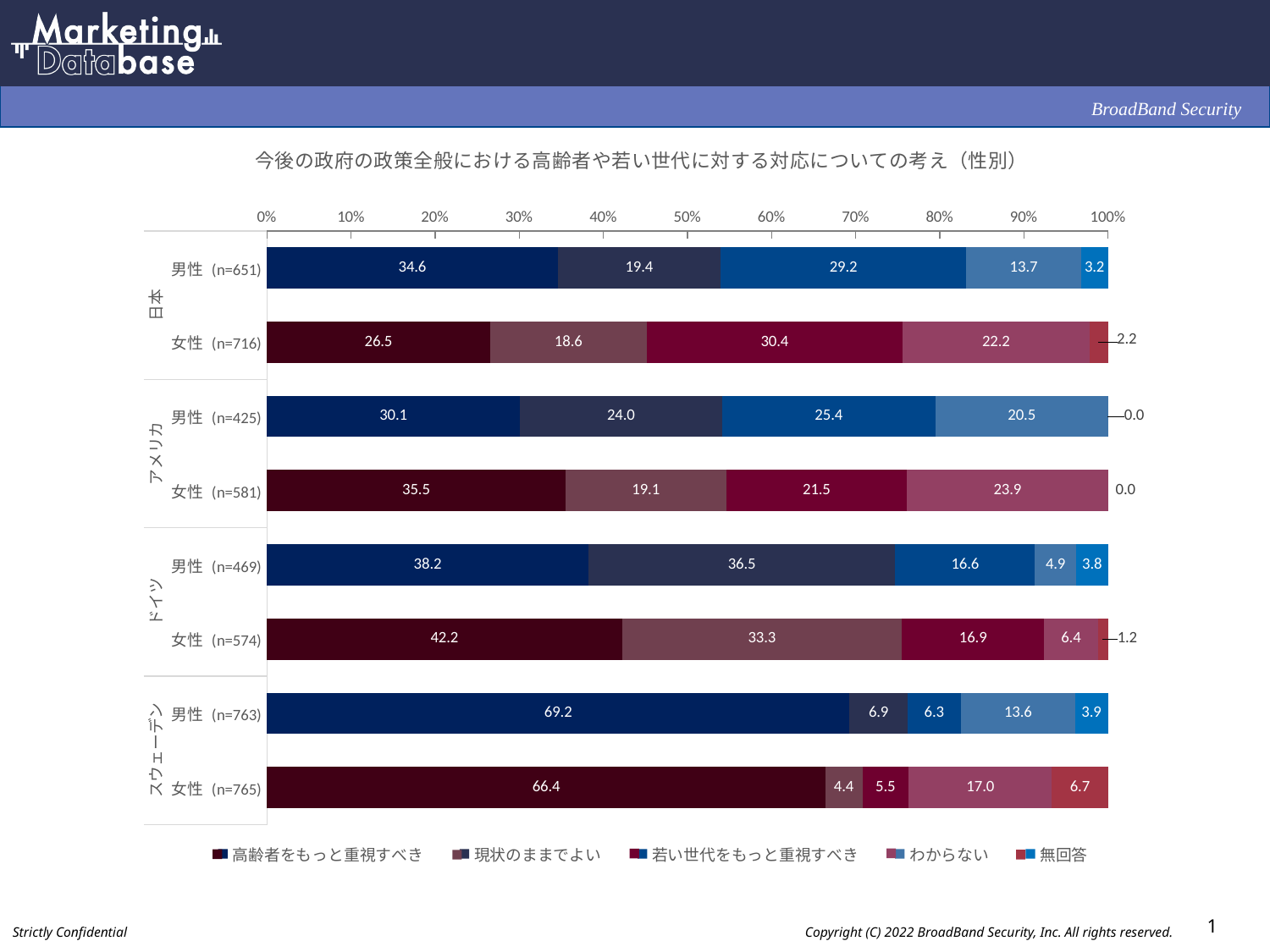
What is the difference between 日本 男性 (n=651) and 日本 女性 (n=716) for 高齢者をもっと重視すべき? 8.1 What is the value of 現状のままでよい for ドイツ 男性 (n=469)? 36.5 Which group has the highest value for 高齢者をもっと重視すべき? スウェーデン 男性 (n=763) How many series does the legend list? 5 What is the value of 若い世代をもっと重視すべき for 日本 女性 (n=716)? 30.4 What is the value of わからない for アメリカ 女性 (n=581)? 23.9 What is the title of the chart? 今後の政府の政策全般における高齢者や若い世代に対する対応についての考え（性別） What is the value of 高齢者をもっと重視すべき for 日本 男性 (n=651)? 34.6 Which group has the lowest value for 高齢者をもっと重視すべき? 日本 女性 (n=716) Which is larger for 無回答: スウェーデン 男性 (n=763) or スウェーデン 女性 (n=765)? スウェーデン 女性 (n=765) What kind of chart is shown on the slide? Stacked bar chart How many bars (respondent groups) are plotted in the chart? 8